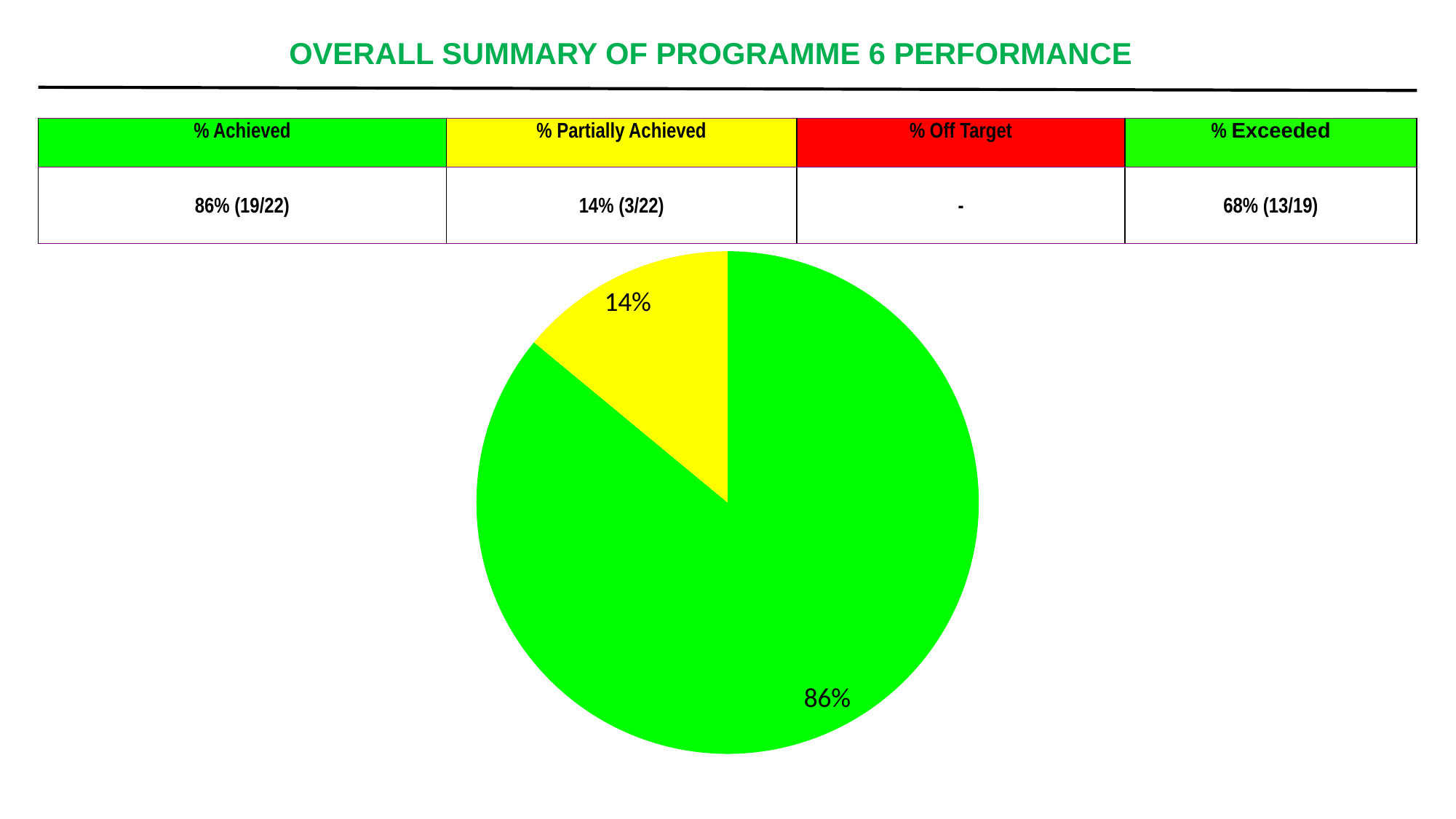
What is the total of the two percentages shown on the pie chart? 100% How many slices does the pie chart have? 2 What is the difference in percentage points between the green slice and the yellow slice of the pie chart? 72 Which slice of the pie chart is the smallest? the yellow slice (14%) What kind of chart is shown on the slide? pie chart Is the green slice or the yellow slice of the pie chart larger? the green slice Which slice of the pie chart is the largest? the green slice (86%) According to the table above the pie chart, what category does the yellow colour represent? % Partially Achieved What colour is the slice labelled 86% in the pie chart? green What percentage is shown on the yellow slice of the pie chart? 14% What share of the pie does the yellow slice represent? 14% What percentage is shown on the green slice of the pie chart? 86%